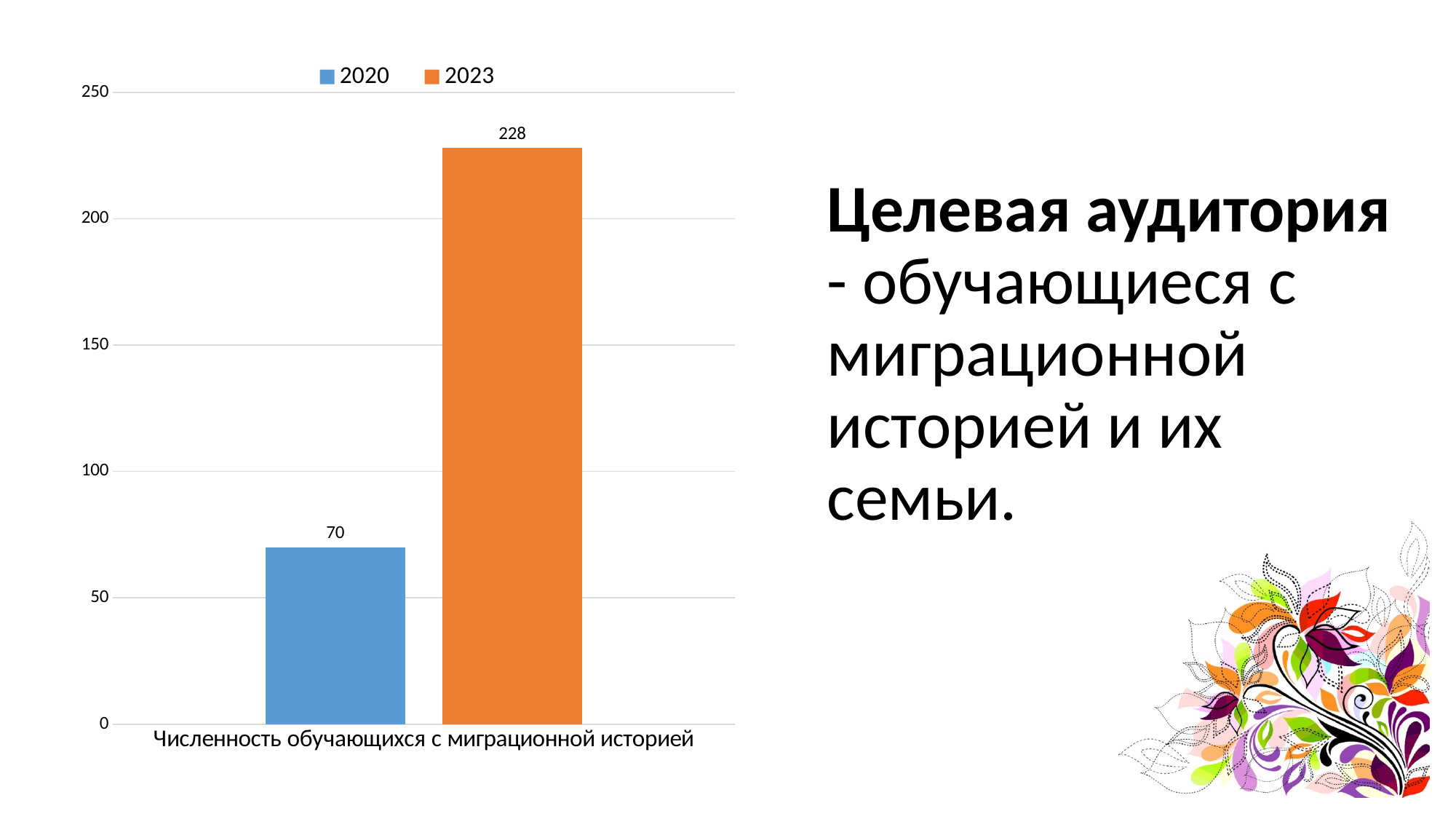
Is the value for 2023 greater or less than 200? greater What is the value for 2020 in the chart? 70 Did the number of students with a migration history rise or fall from 2020 to 2023? rise What is the value for 2023 in the chart? 228 What is the difference between the 2023 value and the 2020 value? 158 Which series has the higher value, 2020 or 2023? 2023 What kind of chart is shown on the slide? bar chart Which series has the lower value, 2020 or 2023? 2020 What is the category label on the x axis of the chart? Численность обучающихся с миграционной историей What colour is the bar for 2023? orange How many series does the legend list? 2 Is the value for 2020 greater or less than 100? less